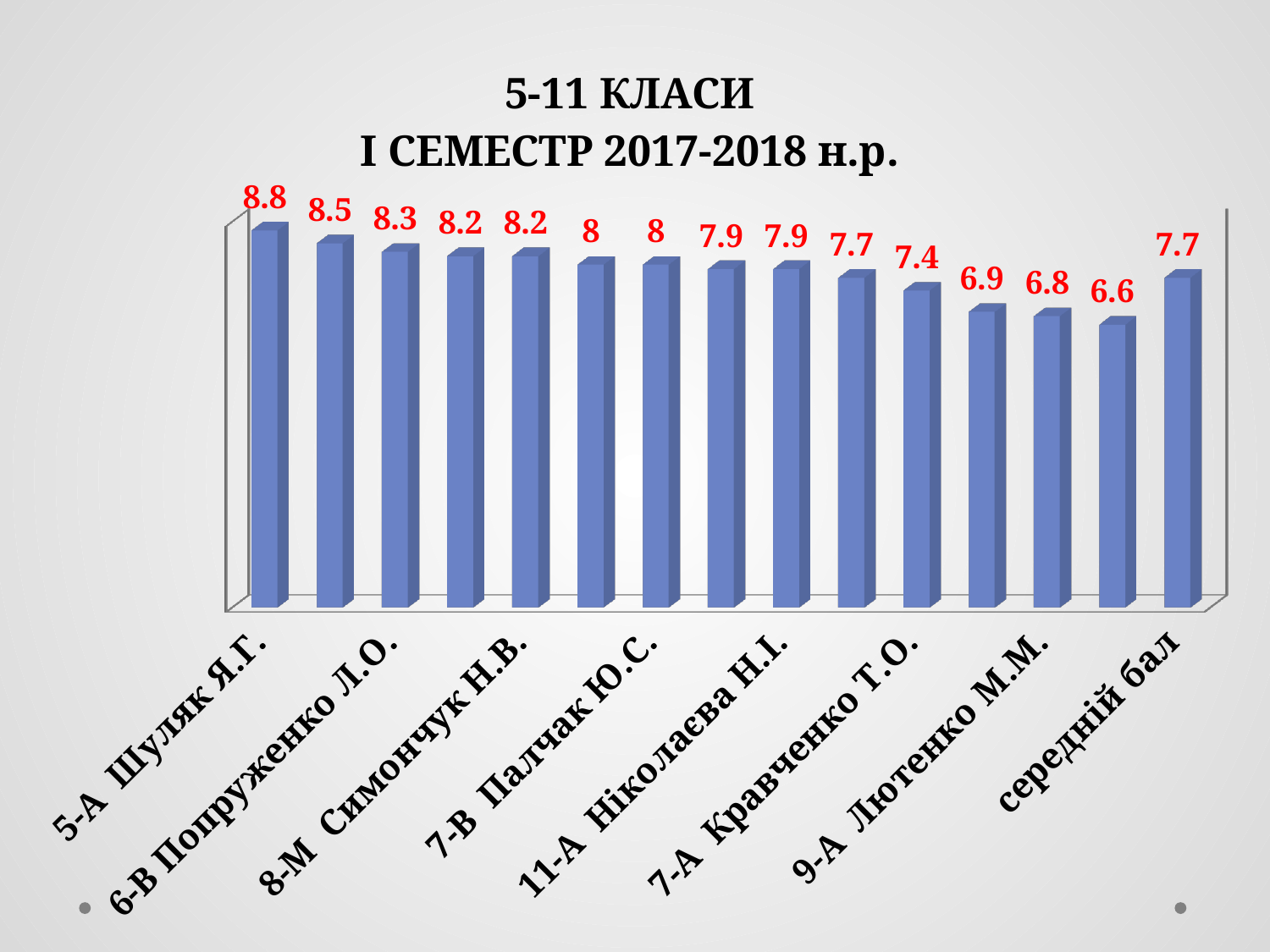
What is the difference between the values for 5-А Шуляк Я.Г. and 9-А Лютенко М.М.? 2 What is the value for 6-В Попруженко Л.О.? 8.3 What is the value for 7-В Палчак Ю.С.? 8 How many bars are plotted in the chart? 15 What is the value for 5-А Шуляк Я.Г.? 8.8 What is the value for 7-А Кравченко Т.О.? 7.4 Which category has the highest value? 5-А Шуляк Я.Г. What is the value for 11-А Ніколаєва Н.І.? 7.9 What is the value for 9-А Лютенко М.М.? 6.8 What is the value of середній бал? 7.7 What type of chart is shown on the slide? bar chart What is the value for 8-М Симончук Н.В.? 8.2